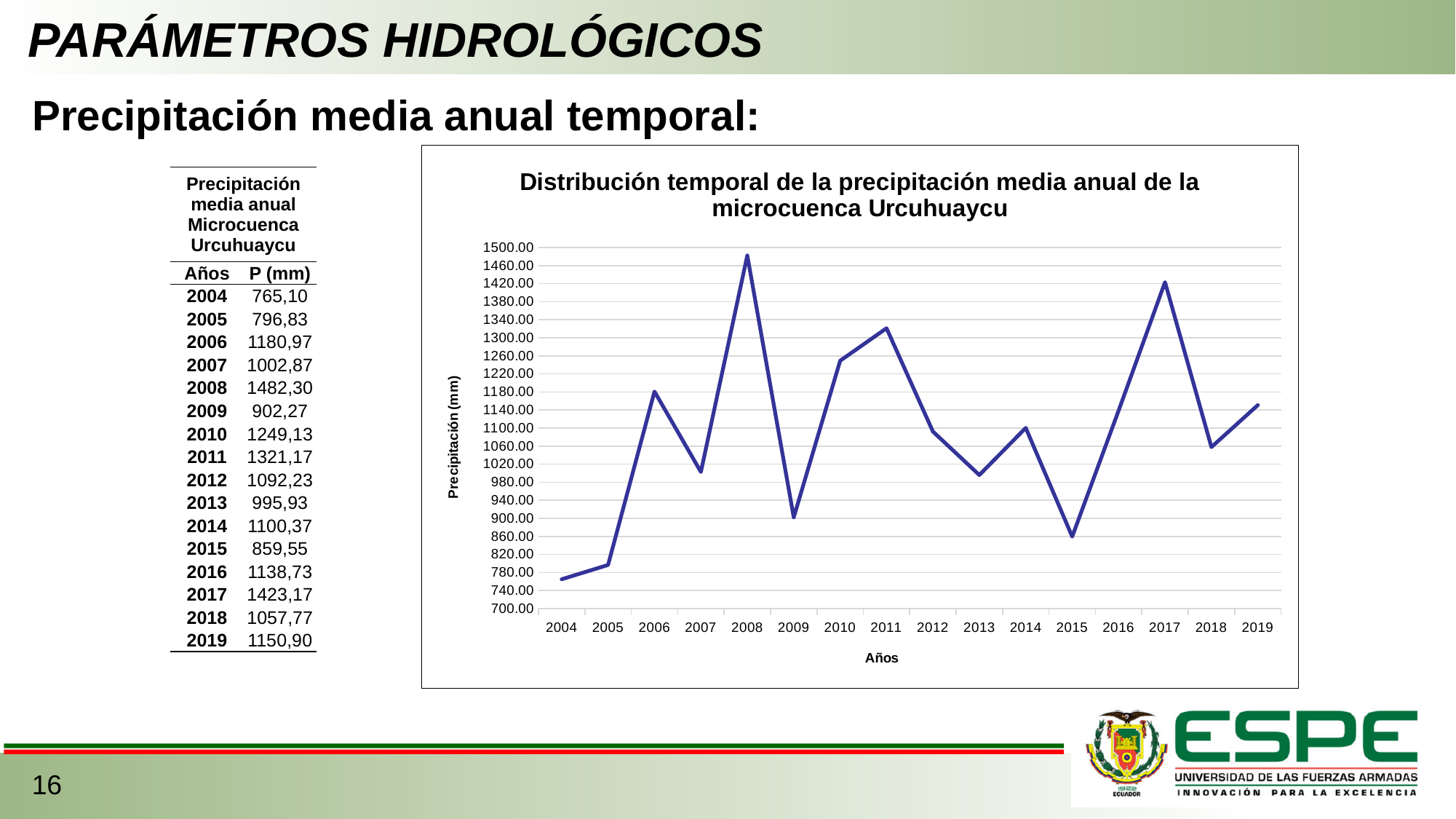
Does the precipitation rise or fall from 2011 to 2013? fall According to the table on the slide, what is the precipitation P (mm) for 2008? 1482,30 Which year has the highest precipitation in the chart? 2008 What is the title of the chart? Distribución temporal de la precipitación media anual de la microcuenca Urcuhuaycu Is the precipitation value for 2009 greater or less than 1000.00? less What is the label of the vertical axis of the chart? Precipitación (mm) Which year has the larger precipitation value, 2011 or 2012? 2011 Using the table values, what is the difference in precipitation between 2008 and 2004? 717,20 Is the precipitation value for 2017 greater or less than 1380.00? greater How many years are plotted along the x axis of the chart? 16 Which year has the lowest precipitation in the chart? 2004 What kind of chart is shown on the slide? line chart